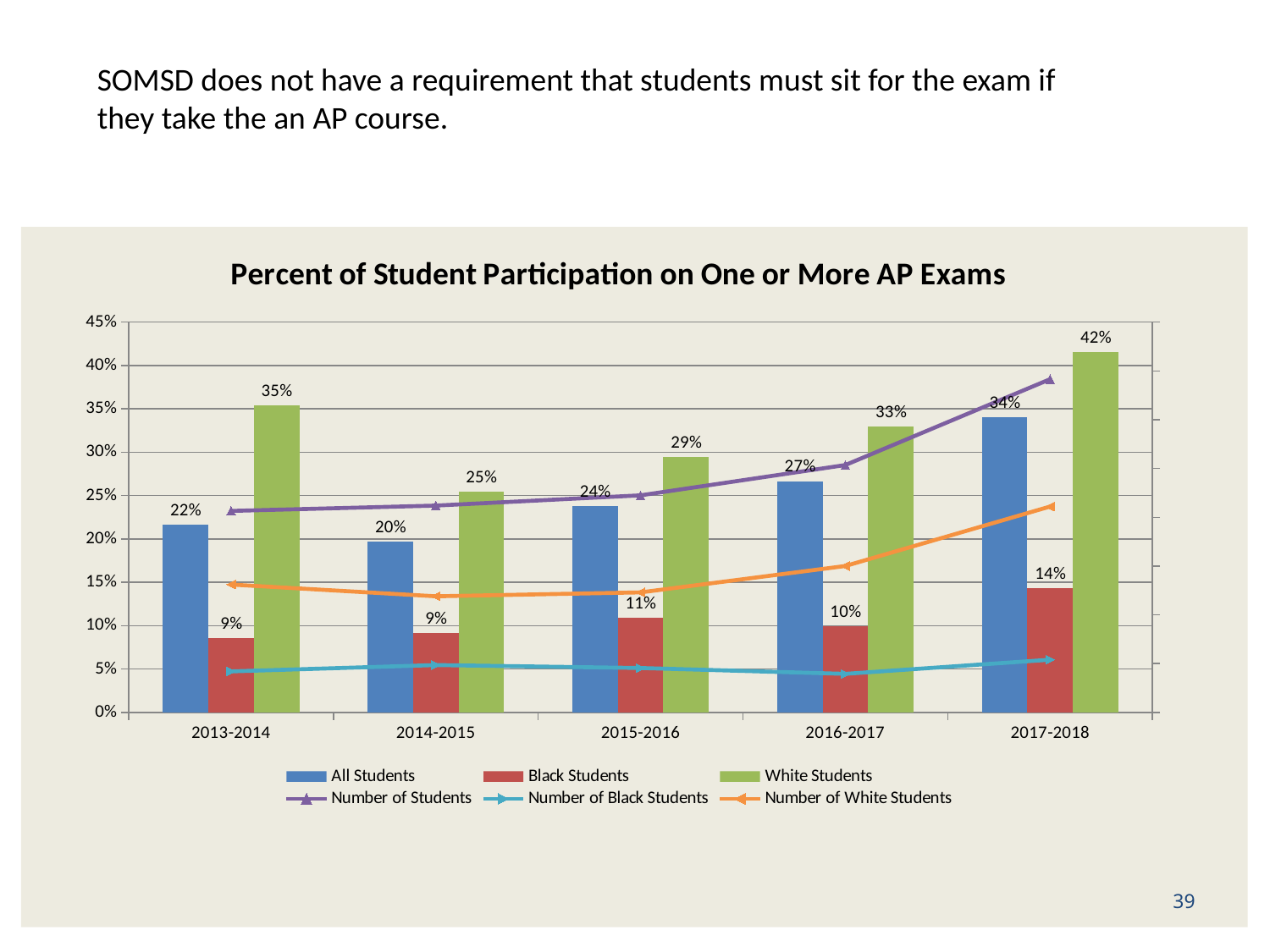
What is the title of the chart? Percent of Student Participation on One or More AP Exams How many school years are shown on the x axis? 5 What is the value for White Students in 2017-2018? 42% How many series does the legend list? 6 Does the value for All Students rise or fall from 2014-2015 to 2017-2018? rise What is the difference between the White Students and Black Students values in 2013-2014? 26% In which school year is the value for All Students highest? 2017-2018 What is the value for All Students in 2014-2015? 20% What is the value for Black Students in 2015-2016? 11% Which is larger in 2016-2017: the value for All Students or the value for White Students? White Students In which school year is the value for White Students lowest? 2014-2015 Is the value for Black Students in 2017-2018 greater or less than 10%? greater